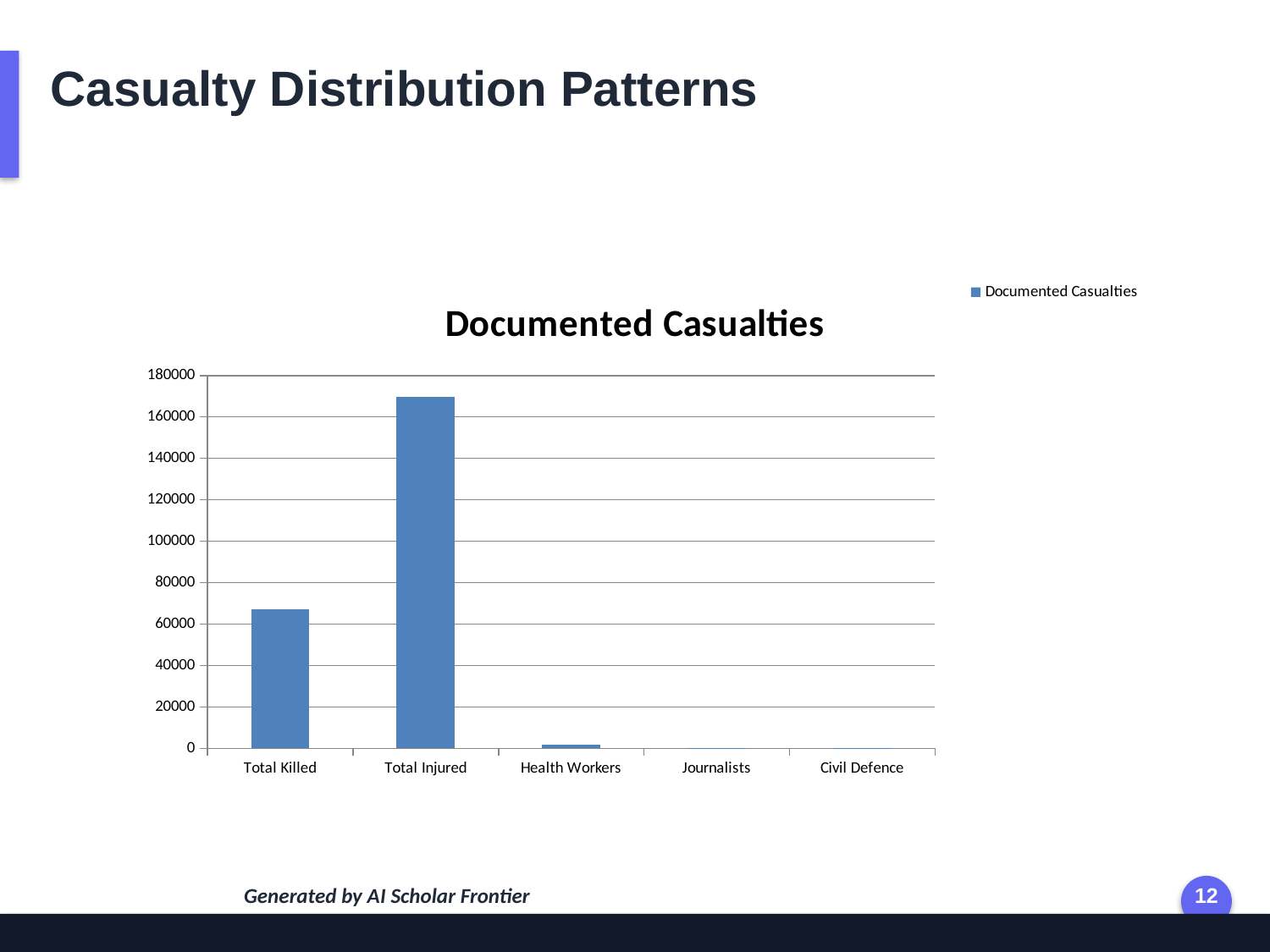
Which of Health Workers and Total Killed has the larger value? Total Killed How many categories are shown on the x axis of the chart? 5 Which category has the highest value? Total Injured Is the value for Total Killed greater or less than 60000? greater Is the value for Total Injured greater or less than 160000? greater Is the value for Total Killed greater or less than 80000? less What kind of chart is shown on the slide? bar chart What is the name of the series shown in the legend? Documented Casualties Which of Total Killed and Total Injured has the larger value? Total Injured What is the title of the chart? Documented Casualties How many series does the legend list? 1